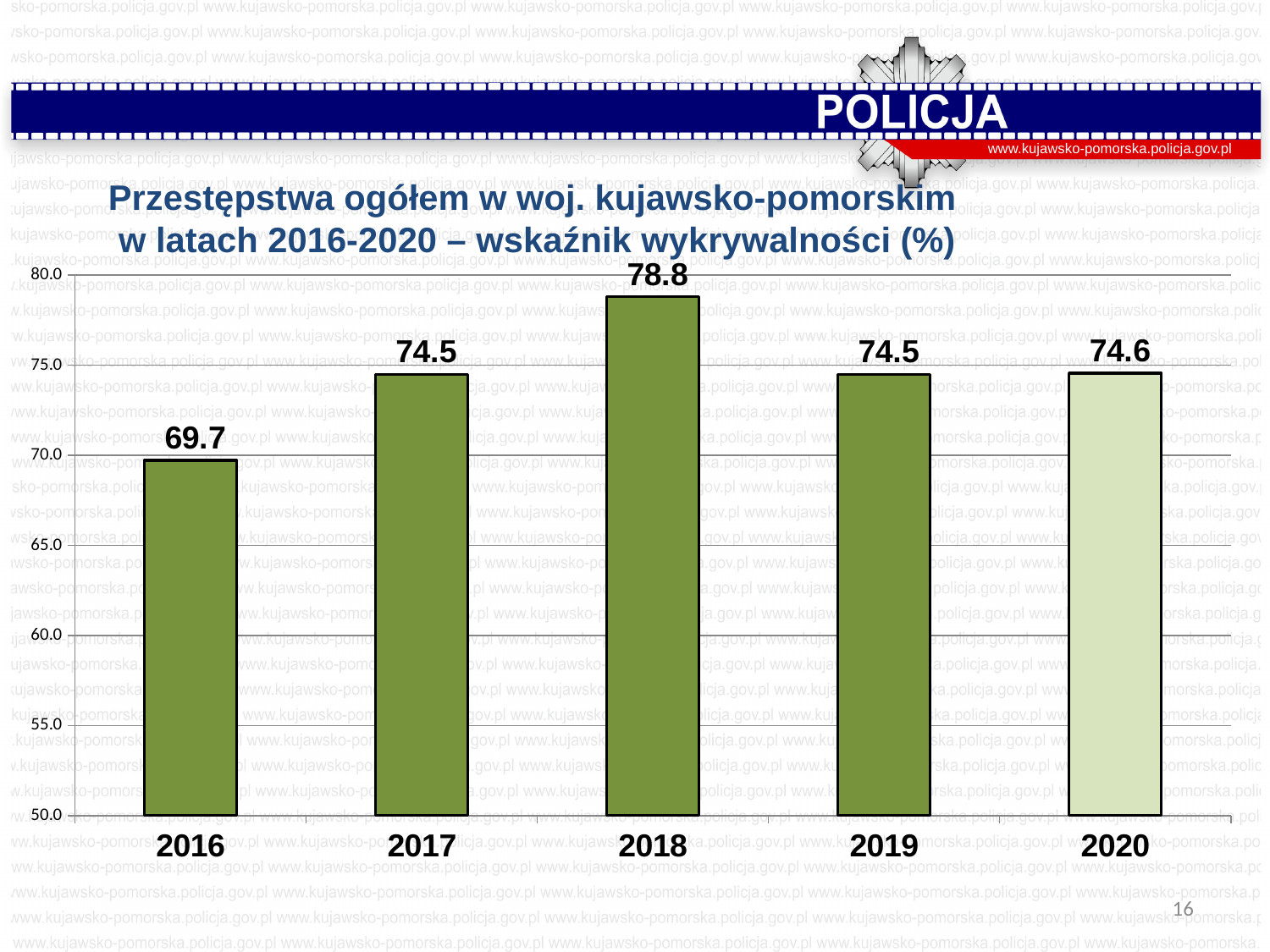
What is the detection rate (wskaźnik wykrywalności) for 2018? 78.8 Do the values rise or fall from 2016 to 2018? rise What kind of chart is shown on the slide? bar chart What is the value shown for 2016? 69.7 Is the value for 2016 greater or less than 70.0? less How many years are shown on the x axis? 5 Which is larger, the value for 2017 or the value for 2016? 2017 What is the title of the chart? Przestępstwa ogółem w woj. kujawsko-pomorskim w latach 2016-2020 – wskaźnik wykrywalności (%) What is the difference between the 2018 value and the 2016 value? 9.1 What is the value shown for 2020? 74.6 Which year has the lowest detection rate? 2016 Which year has the highest detection rate? 2018